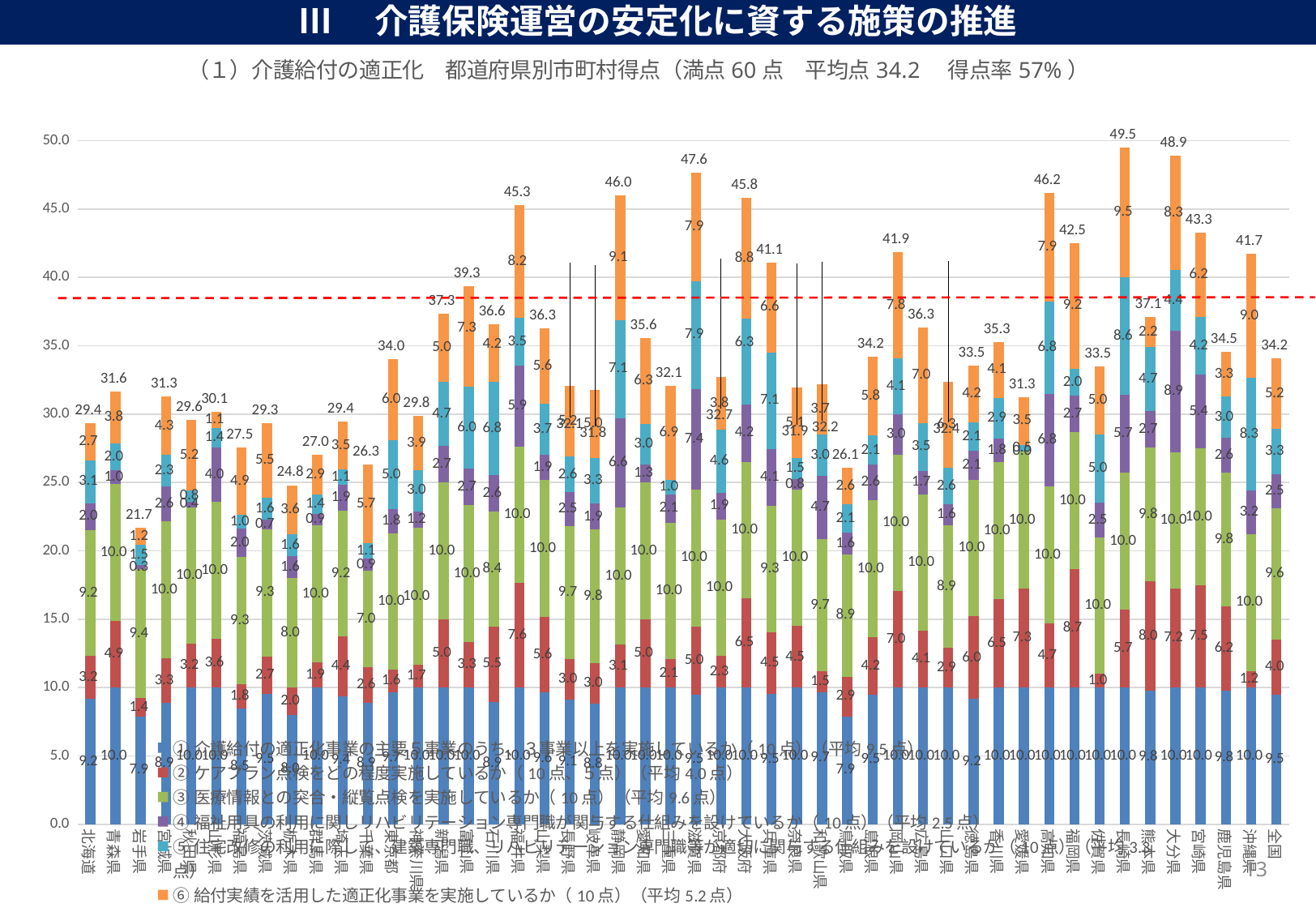
What is the total score shown for 青森県? 31.6 What is the total score shown for 大分県? 48.9 What is the total score shown for 全国? 34.2 What kind of chart is shown on the slide? Stacked bar chart How many series does the legend list? 6 What is the difference between the total scores of 大分県 and 宮崎県? 5.6 What is the highest total score labelled on any bar in the chart? 49.5 What is the value of the ⑥ 給付実績を活用した適正化事業 segment for 全国? 5.2 Which has the lower total score, 岩手県 or 北海道? 岩手県